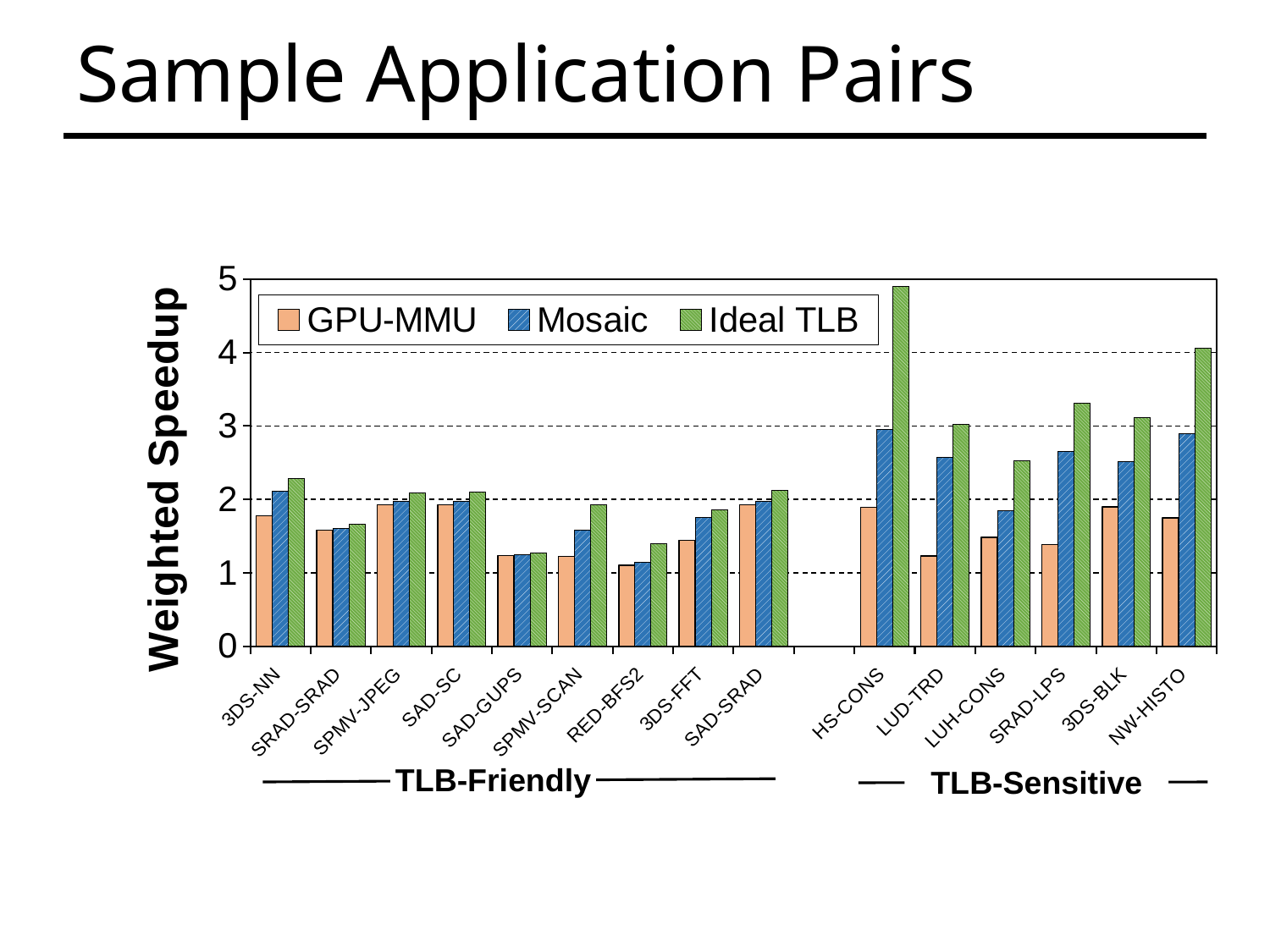
Is the Mosaic value for LUD-TRD greater or less than 2? greater Which application pair has the highest Ideal TLB weighted speedup? HS-CONS Is the Ideal TLB value for SRAD-LPS greater or less than 3? greater Which is larger, the Ideal TLB value for HS-CONS or for SRAD-LPS? HS-CONS What is the label on the y axis of the chart? Weighted Speedup Is the Ideal TLB value for HS-CONS greater or less than 4? greater How many application pairs are shown along the x axis? 15 How many series does the legend list? 3 Which application pair has the lowest GPU-MMU weighted speedup? RED-BFS2 What kind of chart is shown on the slide? bar chart Which is larger, the Mosaic value for 3DS-NN or for SPMV-SCAN? 3DS-NN